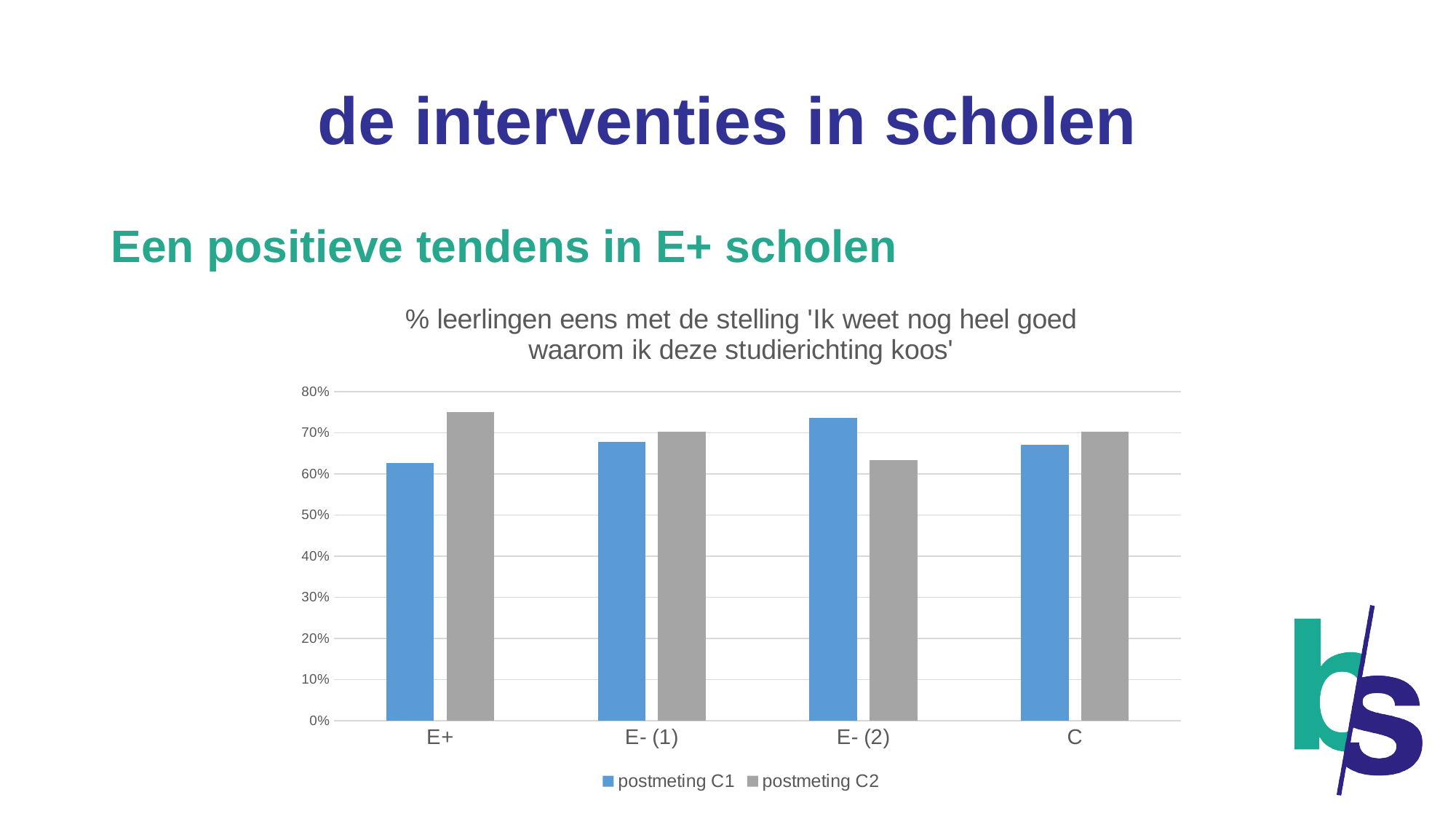
For E- (2), which is larger: postmeting C1 or postmeting C2? postmeting C1 What kind of chart is shown on the slide? bar chart Is the postmeting C1 value for E+ greater or less than 60%? greater How many series does the chart's legend list? 2 What are the two series named in the chart's legend? postmeting C1 and postmeting C2 Which category has the lowest value for postmeting C2? E- (2) Is the postmeting C2 value for E- (2) greater or less than 70%? less How many categories are shown on the x axis of the chart? 4 Which category has the highest value for postmeting C1? E- (2) Which category has the highest value for postmeting C2? E+ Is the postmeting C2 value for E+ greater or less than 70%? greater For E+, which is larger: postmeting C1 or postmeting C2? postmeting C2